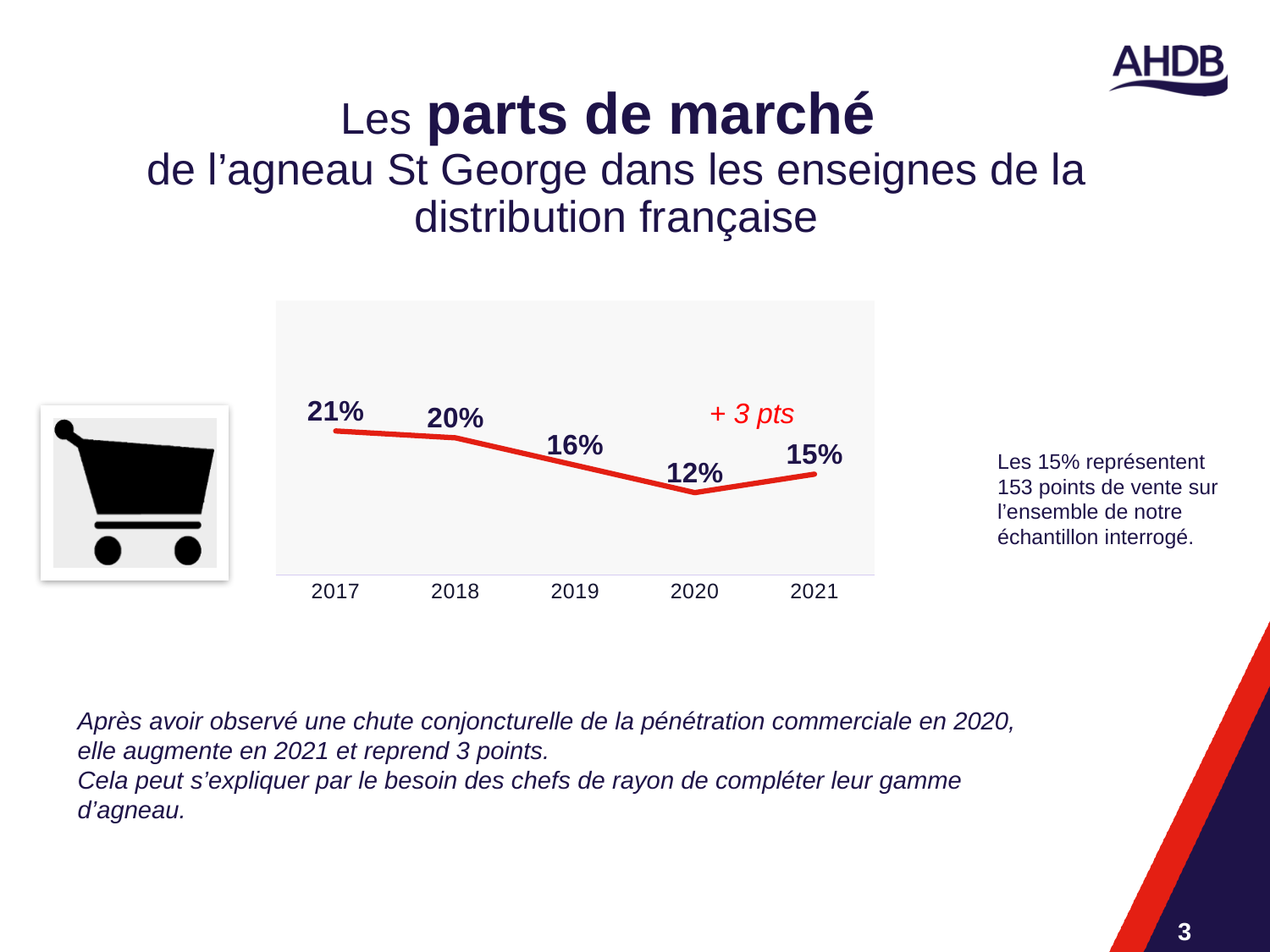
Which year has the lowest market share on the chart? 2020 Which year has the highest market share on the chart? 2017 What is the market share value shown for 2021? 15% Which year has a larger market share, 2018 or 2019? 2018 Does the market share rise or fall from 2017 to 2020? Fall What is the market share value shown for 2017? 21% What kind of chart is shown on the slide? Line chart What is the market share value shown for 2020? 12% What is the difference in market share between 2017 and 2020? 9 percentage points By how many points did the market share change from 2020 to 2021? + 3 pts How many years are plotted on the chart? 5 What is the market share value shown for 2019? 16%